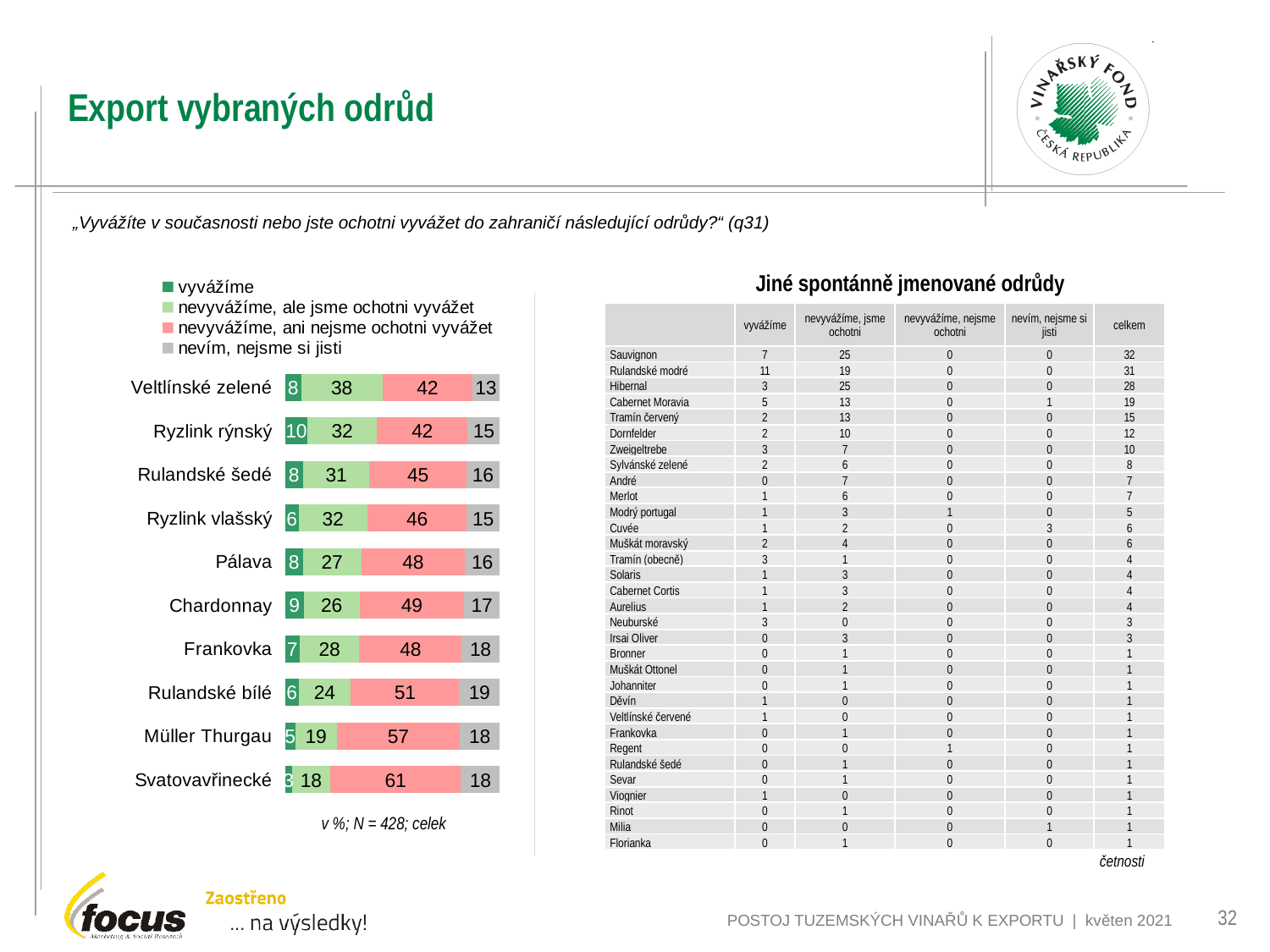
In the bar chart, what percentage of respondents say "vyvážíme" for Ryzlink rýnský? 10 In the bar chart, which has a larger "nevyvážíme, ale jsme ochotni vyvážet" value: Chardonnay or Frankovka? Frankovka In the bar chart, which variety has the lowest "vyvážíme" value? Svatovavřinecké What type of chart is used on the left side of the slide? Stacked bar chart In the bar chart, what is the "nevím, nejsme si jisti" value for Rulandské bílé? 19 In the bar chart, what is the "nevyvážíme, ale jsme ochotni vyvážet" value for Veltlínské zelené? 38 In the bar chart, what is the difference between the "nevyvážíme, ani nejsme ochotni vyvážet" values for Müller Thurgau and Pálava? 9 How many varieties are shown in the bar chart? 10 How many series does the bar chart legend list? 4 In the bar chart, which variety has the highest "nevyvážíme, ani nejsme ochotni vyvážet" value? Svatovavřinecké In the bar chart, what is the value of "nevyvážíme, ani nejsme ochotni vyvážet" for Svatovavřinecké? 61 In the bar chart, what is the total of the stacked bar for Rulandské šedé? 100